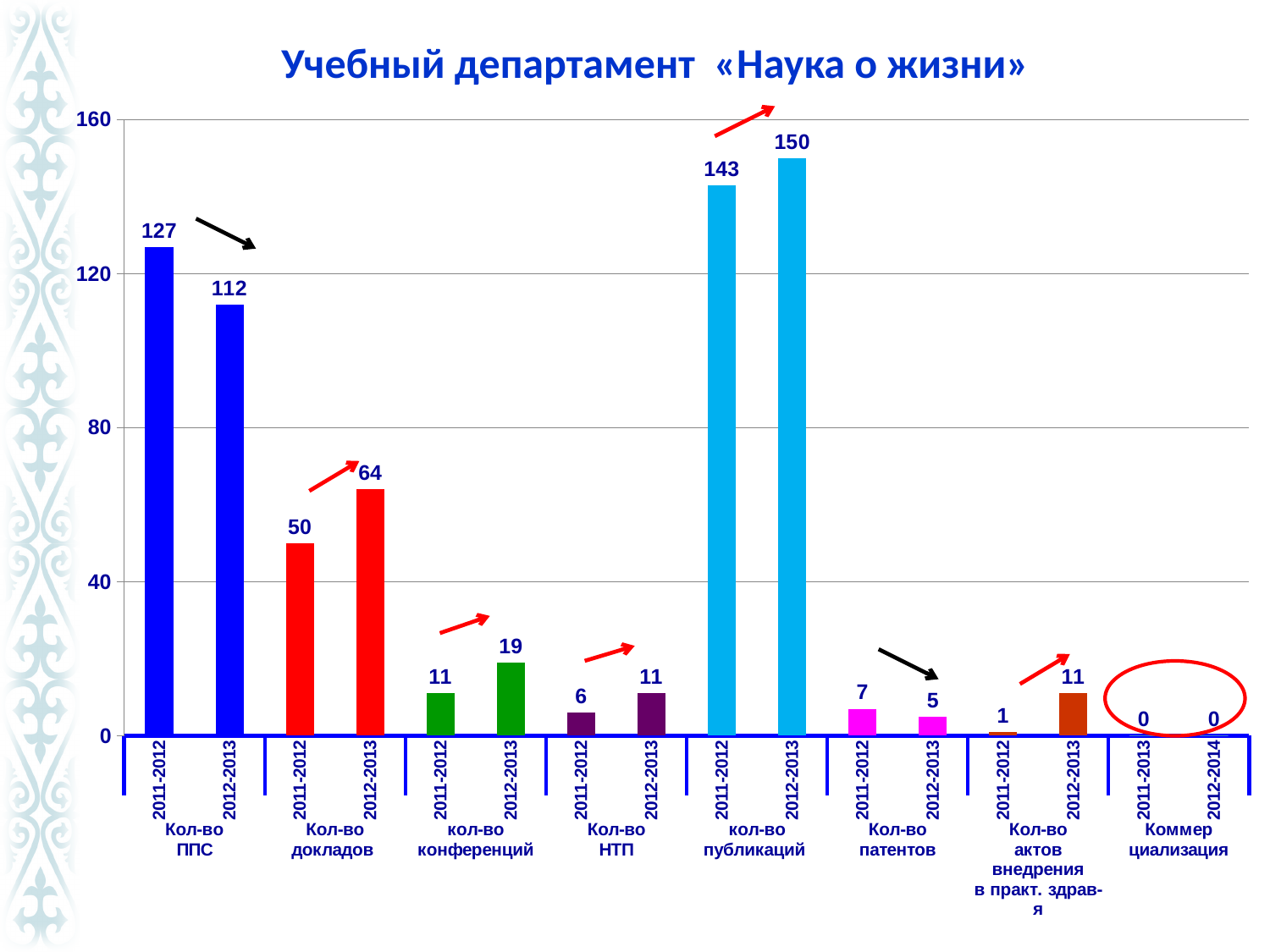
What is the difference between the 2012-2013 and 2011-2012 values for Кол-во докладов? 14 What is the value for Кол-во докладов in 2011-2012? 50 What is the value for Кол-во ППС in 2012-2013? 112 What is the value for Кол-во патентов in 2012-2013? 5 What is the value for Кол-во ППС in 2011-2012? 127 What type of chart is shown on the slide? Bar chart Which is larger for Кол-во патентов: the 2011-2012 value or the 2012-2013 value? 2011-2012 What is the title of the chart? Учебный департамент «Наука о жизни» Which bar has the highest value on the chart? кол-во публикаций, 2012-2013 (150) How many category groups are shown along the x axis? 8 What is the value for кол-во публикаций in 2012-2013? 150 What is the difference between the 2011-2012 and 2012-2013 values for Кол-во ППС? 15